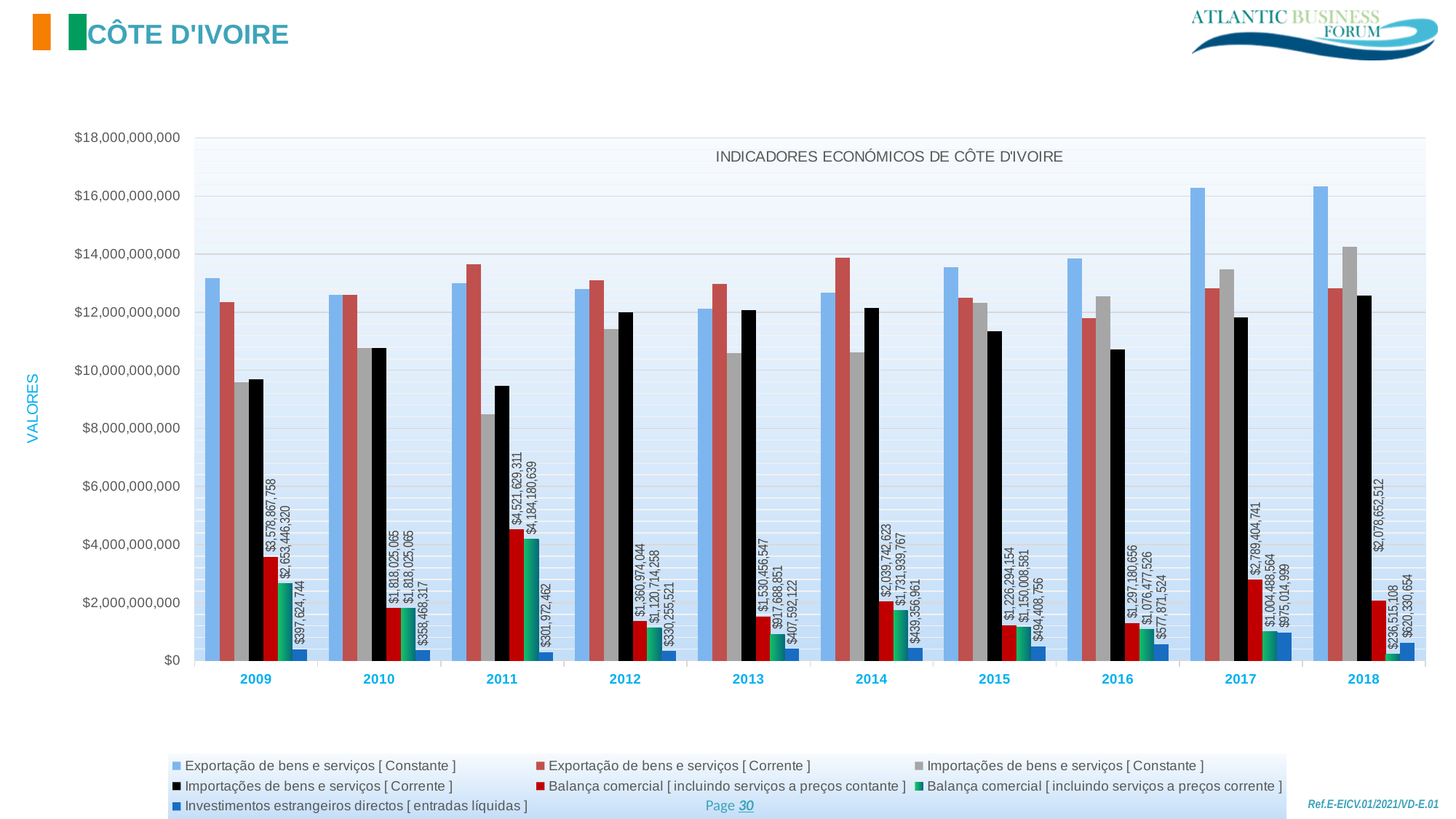
How many series does the legend list? 7 In which year is Investimentos estrangeiros directos [ entradas líquidas ] lowest? 2011 How many years are shown on the x axis of the chart? 10 What is the value of Investimentos estrangeiros directos [ entradas líquidas ] for 2017? $975,014,999 Which year has the larger value for Investimentos estrangeiros directos [ entradas líquidas ], 2015 or 2016? 2016 In which year is Balança comercial [ incluindo serviços a preços corrente ] highest? 2011 What is the title of the chart? INDICADORES ECONÓMICOS DE CÔTE D'IVOIRE Is the value of Exportação de bens e serviços [ Constante ] for 2017 greater or less than $16,000,000,000? greater What is the value of Balança comercial [ incluindo serviços a preços contante ] for 2011? $4,521,629,311 Is the value of Importações de bens e serviços [ Constante ] for 2011 greater or less than $10,000,000,000? less What is the difference between Balança comercial [ incluindo serviços a preços contante ] and Balança comercial [ incluindo serviços a preços corrente ] in 2009? $925,421,438 What is the value of Balança comercial [ incluindo serviços a preços corrente ] for 2018? $236,515,108